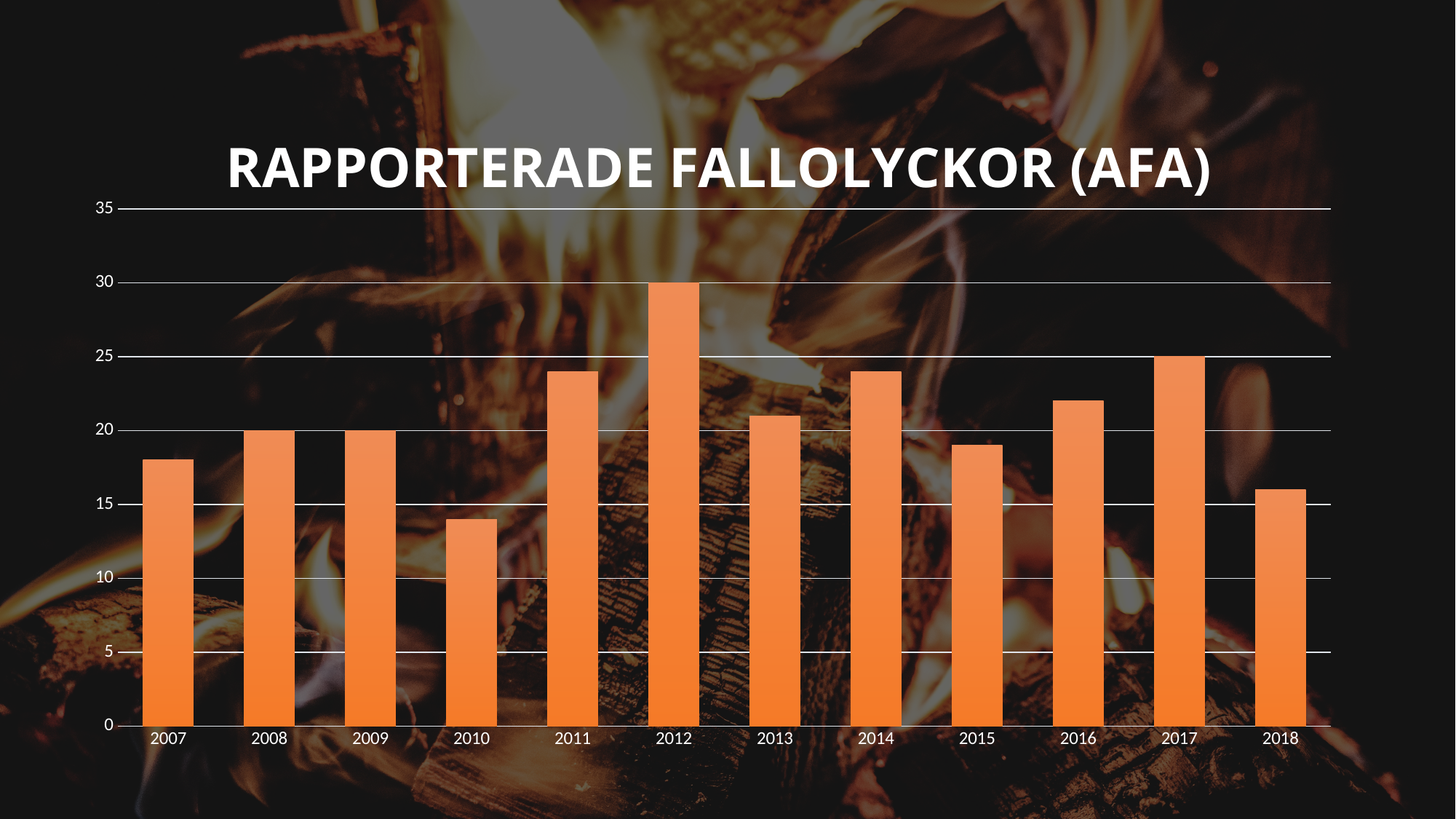
Which year has the highest number of reported fall accidents? 2012 What type of chart is shown on the slide? bar chart Which year has the larger value, 2012 or 2017? 2012 What is the value for 2012? 30 Is the value for 2010 greater or less than 15? less What is the title of the chart? RAPPORTERADE FALLOLYCKOR (AFA) How many years are shown on the x axis of the chart? 12 Is the value for 2016 greater or less than 20? greater What is the value for 2017? 25 What is the difference between the values for 2012 and 2017? 5 Which year has the lowest number of reported fall accidents? 2010 What is the value for 2008? 20